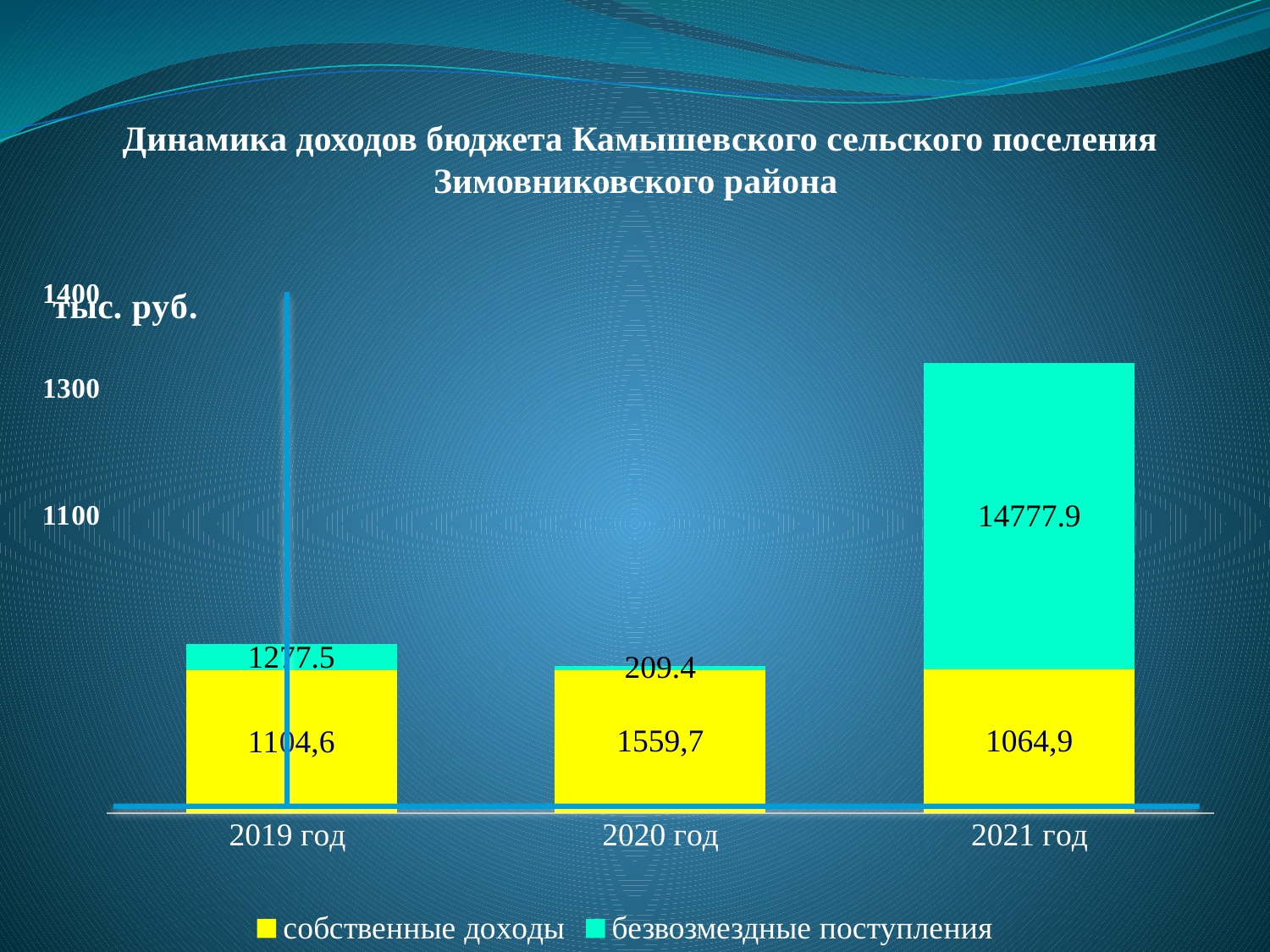
What is the difference between собственные доходы in 2020 год and 2019 год? 455,1 What is the value of собственные доходы for 2021 год? 1064,9 What type of chart is shown on the slide? Stacked bar chart What is the value of собственные доходы for 2020 год? 1559,7 Which year has the lowest value of безвозмездные поступления? 2020 год What is the value of собственные доходы for 2019 год? 1104,6 Which year has the larger value of собственные доходы, 2019 год or 2020 год? 2020 год Which year has the tallest stacked bar overall? 2021 год What is the value of безвозмездные поступления for 2021 год? 14777.9 What is the value of безвозмездные поступления for 2020 год? 209.4 How many series does the chart legend list? 2 How many years (categories) are shown on the x axis of the chart? 3